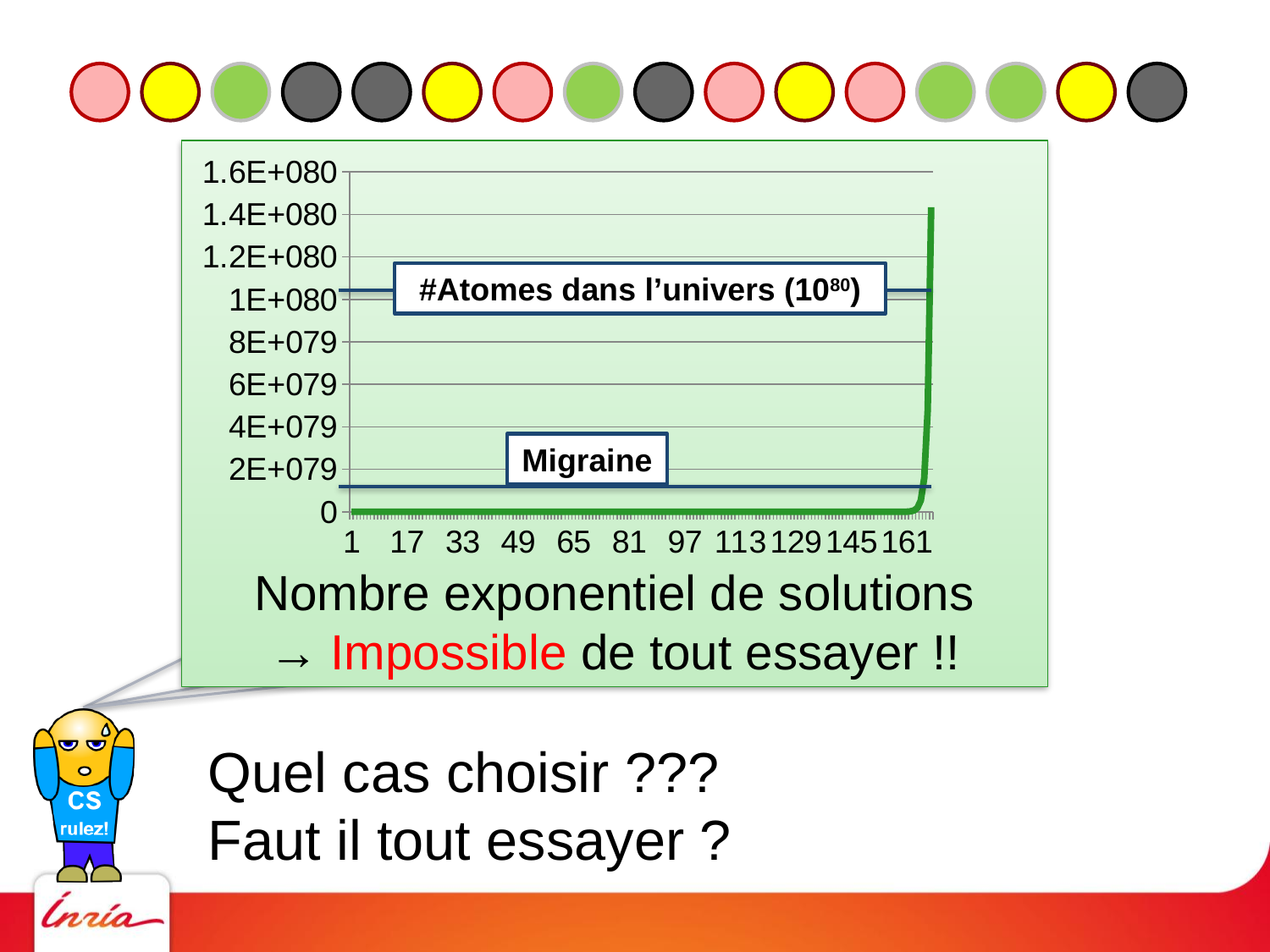
How many tick labels are shown on the x axis? 11 What kind of chart is shown on the slide? line chart At what value on the y axis is the '#Atomes dans l'univers' line drawn? 1E+080 Which is higher on the chart, the '#Atomes dans l'univers' line or the 'Migraine' line? #Atomes dans l'univers Is the value of the green curve at x = 81 greater or less than 2E+079? less What is the label of the lower horizontal line on the chart? Migraine What is the label of the horizontal line drawn at 1E+080 on the chart? #Atomes dans l'univers (10^80) Does the green curve rise or fall as the x axis increases? rises What is the highest tick value shown on the y axis? 1.6E+080 What is the last tick label shown on the x axis? 161 Is the peak value of the green curve greater or less than 1.2E+080? greater Is the value of the 'Migraine' line greater or less than 2E+079? less